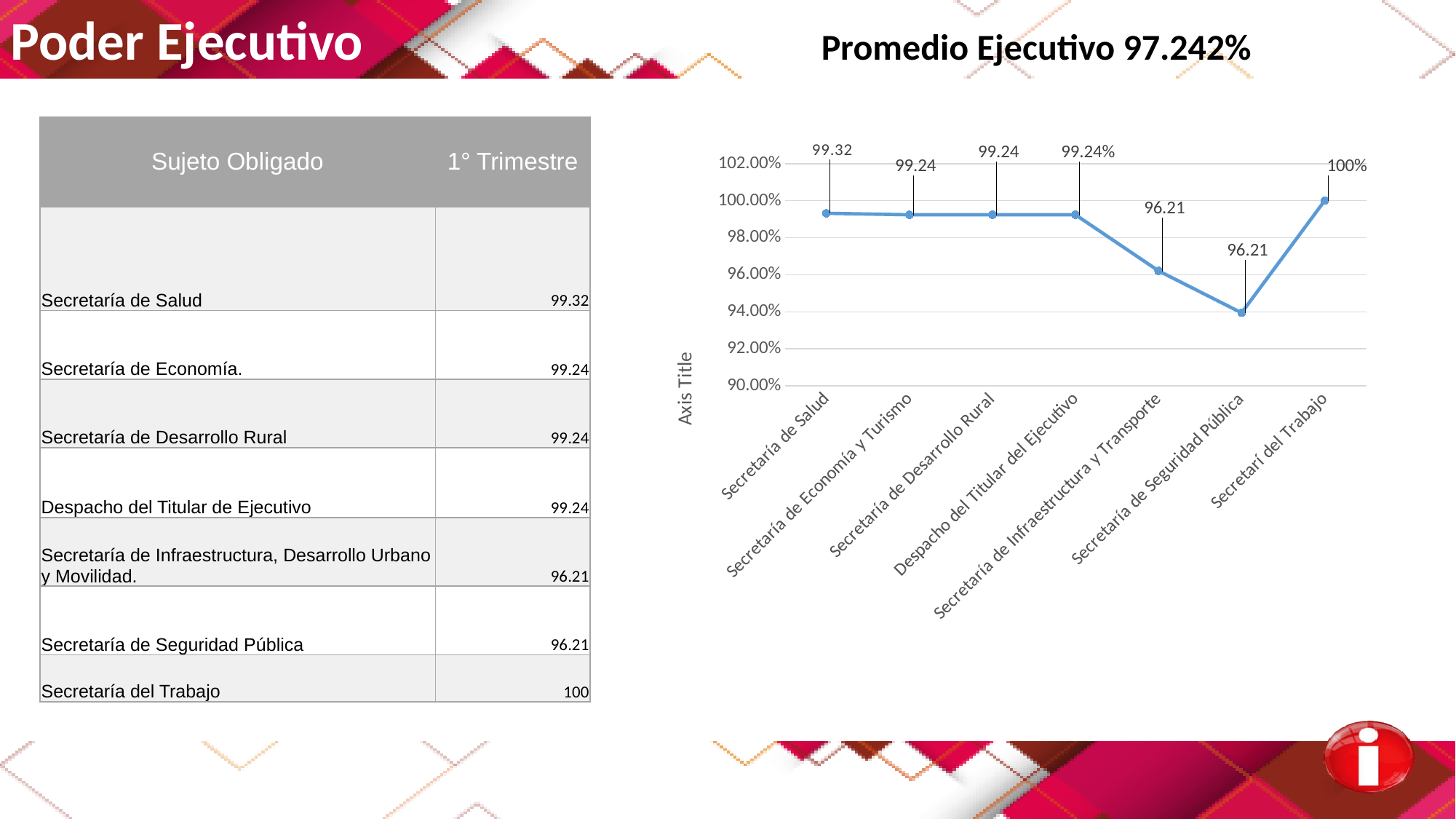
What is the value labelled for Secretaría de Salud in the chart? 99.32 Which is larger, the value for Secretaría de Salud or the value for Secretaría de Seguridad Pública? Secretaría de Salud What is the title shown on the vertical axis of the chart? Axis Title How many categories are plotted along the x axis of the chart? 7 What is the difference between the labelled values for Secretarí del Trabajo and Secretaría de Infraestructura y Transporte? 3.79 What is the value labelled for Secretaría de Infraestructura y Transporte in the chart? 96.21 What is the value labelled for Despacho del Titular del Ejecutivo in the chart? 99.24% Which category has the highest value in the chart? Secretarí del Trabajo What kind of chart is shown on the slide? line chart What is the difference between the labelled values for Secretaría de Salud and Secretaría de Economía y Turismo? 0.08 What is the value labelled for Secretaría de Economía y Turismo in the chart? 99.24 Is the plotted value for Secretaría de Infraestructura y Transporte greater or less than 98.00%? less